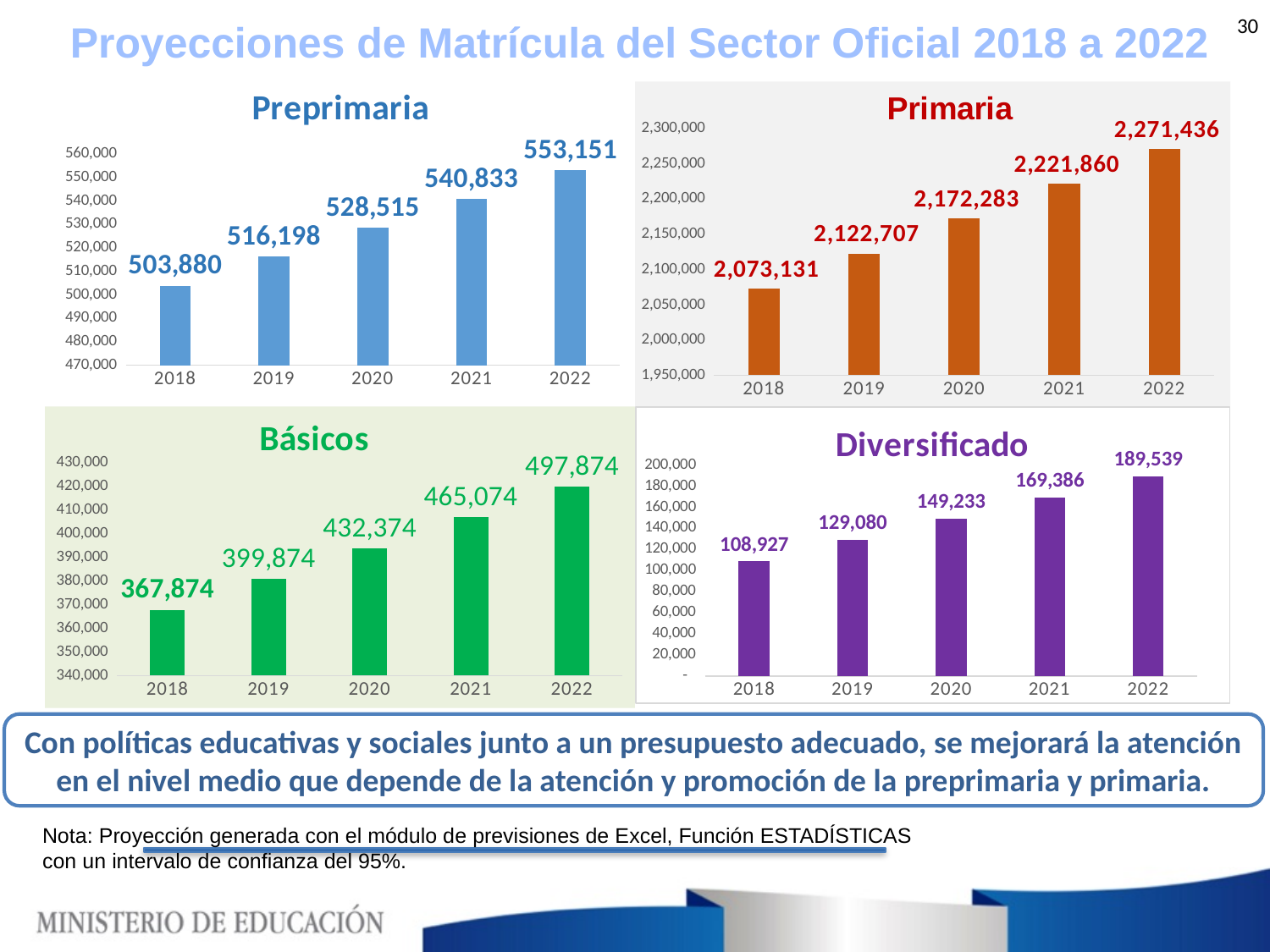
How many years are shown on the x axis of the Básicos chart? 5 In the Básicos chart, what is the value for 2018? 367,874 In the Diversificado chart, do the values rise or fall from 2018 to 2022? rise In the Básicos chart, what is the difference between the 2020 and 2019 values? 32,500 In the Primaria chart, what is the value for 2022? 2,271,436 What kind of chart is the Primaria chart? bar chart In the Diversificado chart, what is the value for 2021? 169,386 In the Preprimaria chart, what is the difference between the 2022 and 2018 values? 49,271 In the Preprimaria chart, what is the value for 2020? 528,515 In the Primaria chart, which year has the highest value? 2022 In the Diversificado chart, which year has the lowest value? 2018 In the Diversificado chart, is the value for 2019 greater or less than 140,000? less